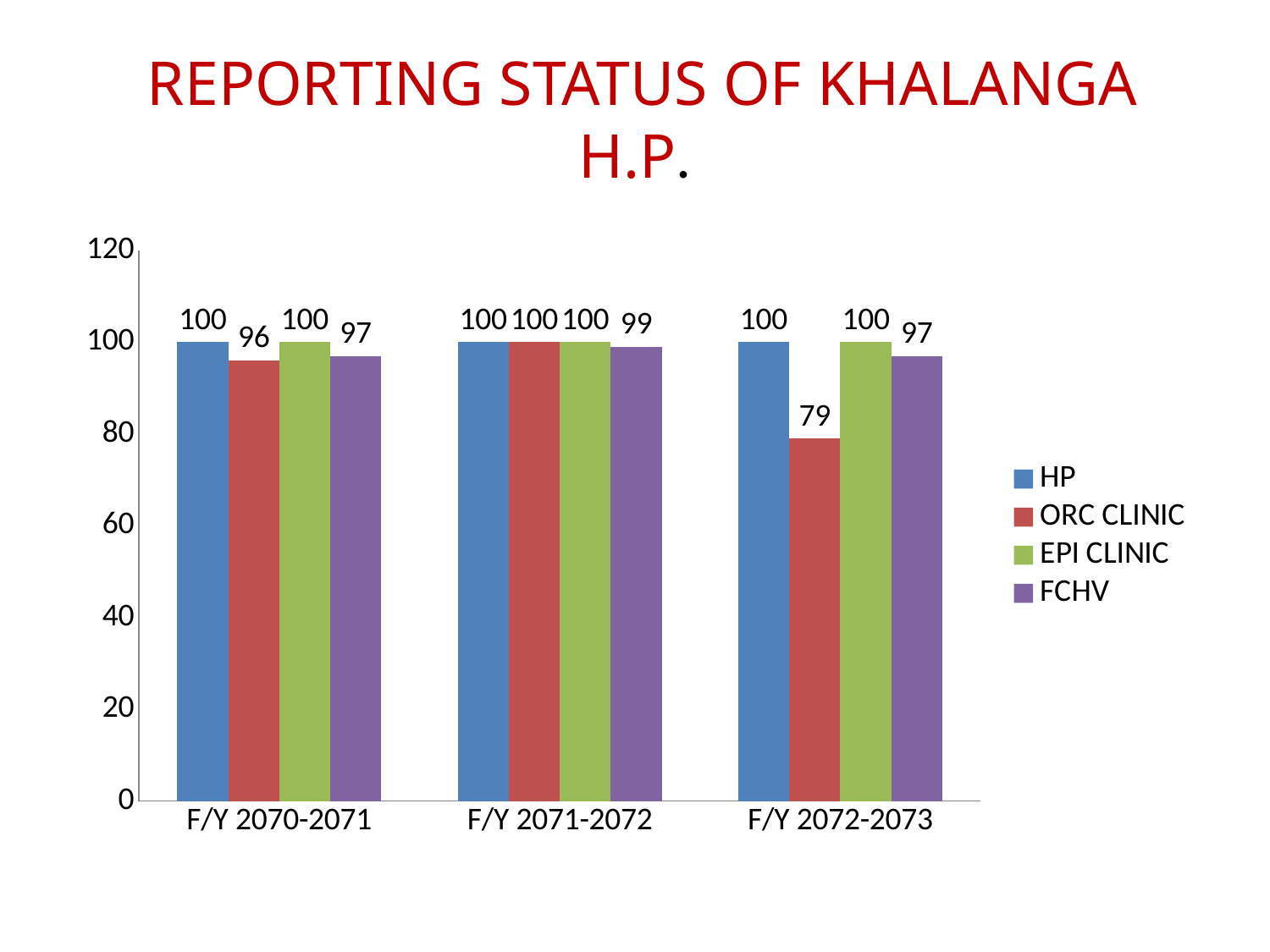
Which series has the lowest value in F/Y 2072-2073? ORC CLINIC What is the difference between the ORC CLINIC values for F/Y 2071-2072 and F/Y 2072-2073? 21 What is the value for ORC CLINIC in F/Y 2072-2073? 79 How many series does the legend list? 4 Which is larger: the FCHV value in F/Y 2071-2072 or the FCHV value in F/Y 2072-2073? F/Y 2071-2072 What is the value for FCHV in F/Y 2071-2072? 99 How many fiscal year categories are shown on the x axis? 3 What kind of chart is shown on the slide? Bar chart What is the value for HP in F/Y 2072-2073? 100 What is the value for ORC CLINIC in F/Y 2070-2071? 96 Is the value for ORC CLINIC in F/Y 2072-2073 greater or less than 80? less Which series has the lowest value in F/Y 2070-2071? ORC CLINIC